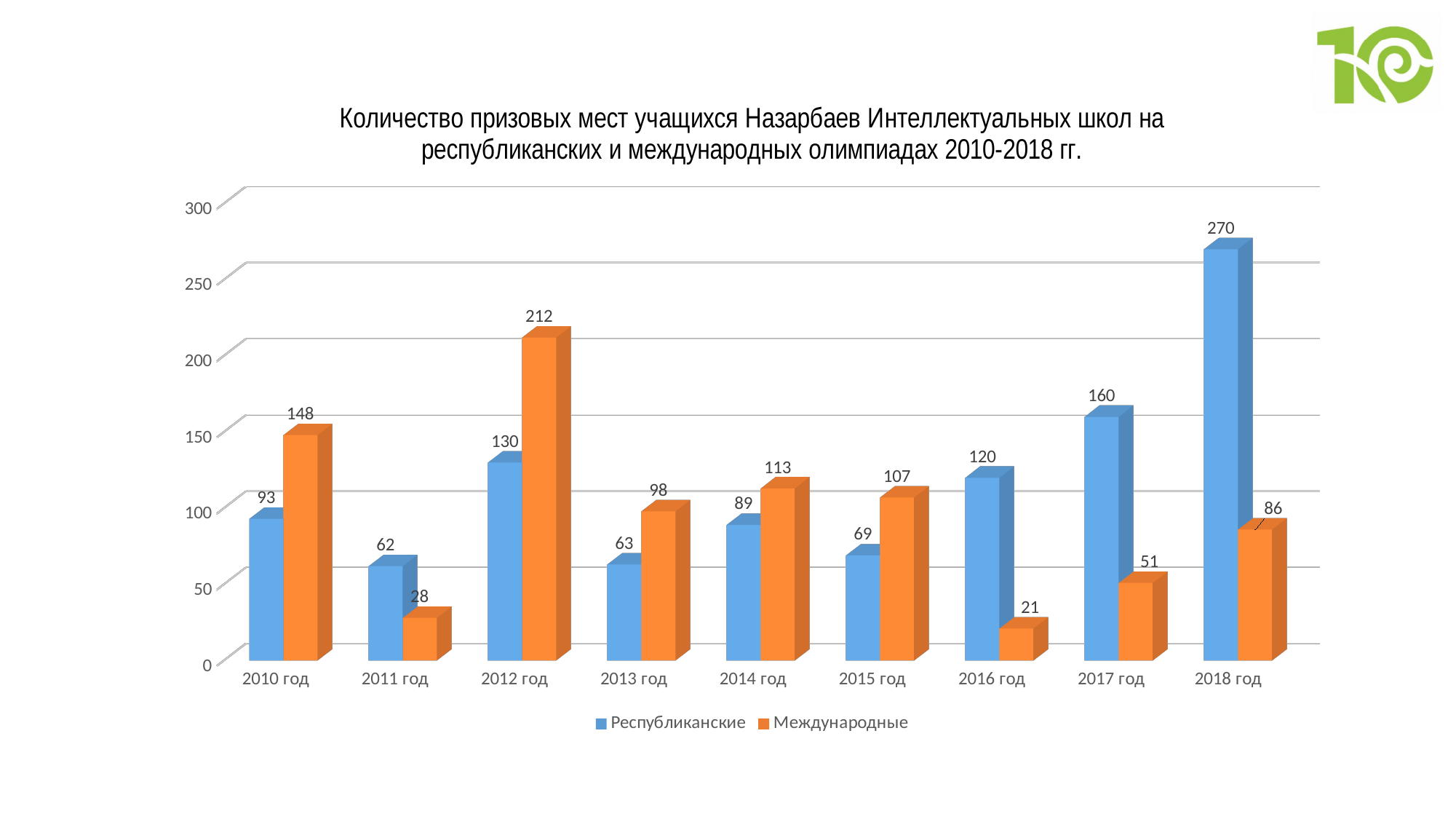
Which year has the highest value for Республиканские? 2018 год Which year has the highest value for Международные? 2012 год What kind of chart is shown on the slide? bar chart What colour are the bars for Международные? orange Which is larger in 2017 год: Республиканские or Международные? Республиканские What is the difference between Республиканские in 2018 год and 2017 год? 110 How many years are shown on the x axis? 9 What is the value for Республиканские in 2012 год? 130 What is the value for Международные in 2016 год? 21 Which year has the lowest value for Международные? 2016 год How many series does the legend list? 2 What is the difference between Международные and Республиканские in 2012 год? 82